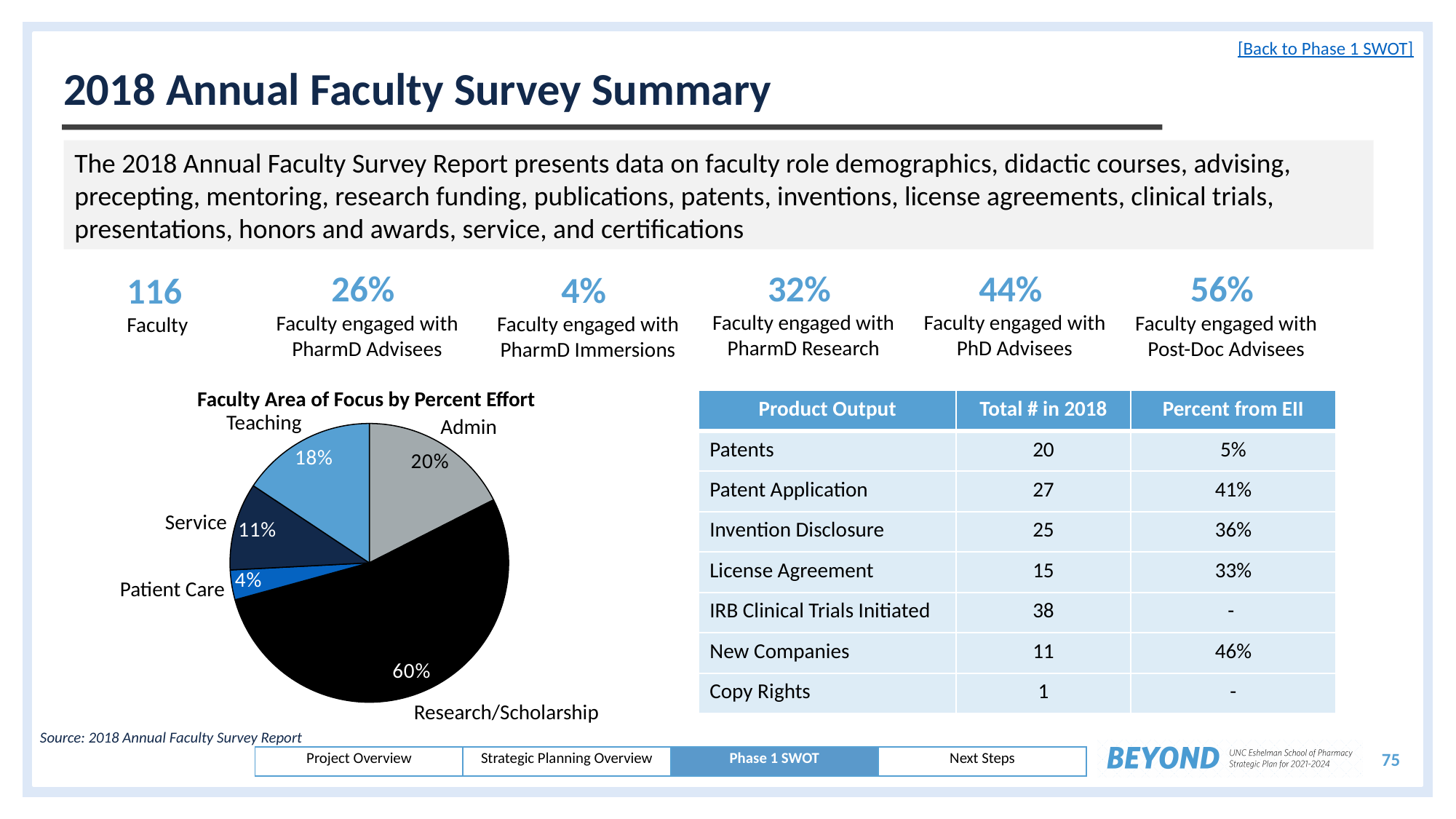
What type of chart is 'Faculty Area of Focus by Percent Effort'? pie chart In the pie chart, what is the value for Admin? 20% In the pie chart, what is the value for Patient Care? 4% What is the title of the pie chart? Faculty Area of Focus by Percent Effort In the pie chart, what is the value for Service? 11% How many slices does the pie chart have? 5 In the pie chart, which is larger: Service or Patient Care? Service Which area of focus has the smallest share of the pie chart? Patient Care In the pie chart, what is the difference between the Admin and Teaching values? 2% In the pie chart, what is the value for Research/Scholarship? 60% In the pie chart, what is the value for Teaching? 18% Which area of focus has the largest share of the pie chart? Research/Scholarship